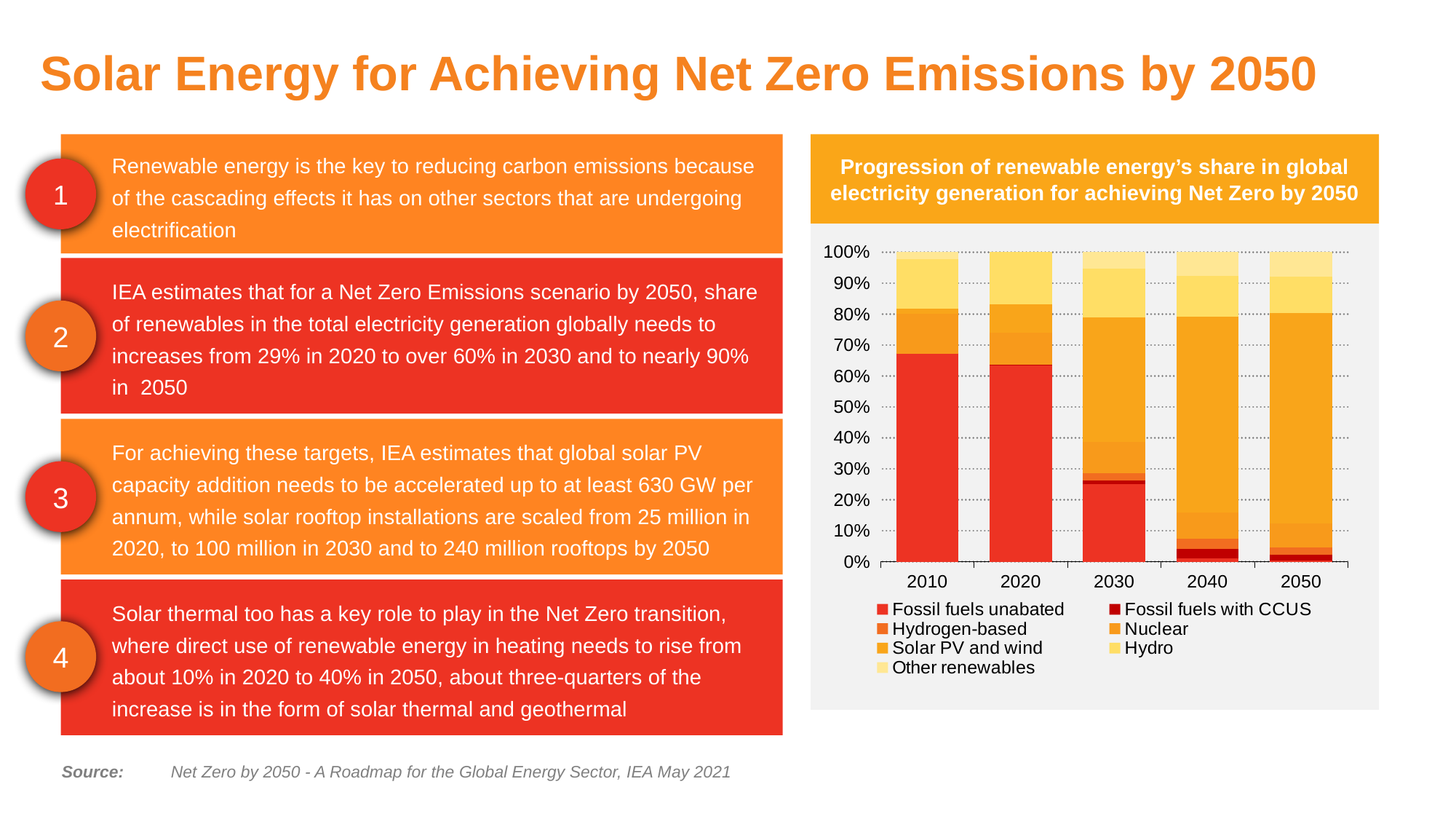
Does the share of Fossil fuels unabated rise or fall from 2010 to 2050? Fall What kind of chart is shown on the slide? Stacked bar chart Which series is shown in the lightest yellow colour at the top of each bar? Other renewables How many series does the chart legend list? 7 Is the share of Fossil fuels unabated in 2040 greater or less than 10%? less Which year has a larger share of Fossil fuels unabated, 2020 or 2030? 2020 Is the share of Fossil fuels unabated in 2010 greater or less than 60%? greater What is the title of the chart? Progression of renewable energy's share in global electricity generation for achieving Net Zero by 2050 How many years are shown on the x axis of the chart? 5 Is the share of Fossil fuels unabated in 2050 greater or less than 10%? less In which year is the share of Fossil fuels unabated the highest? 2010